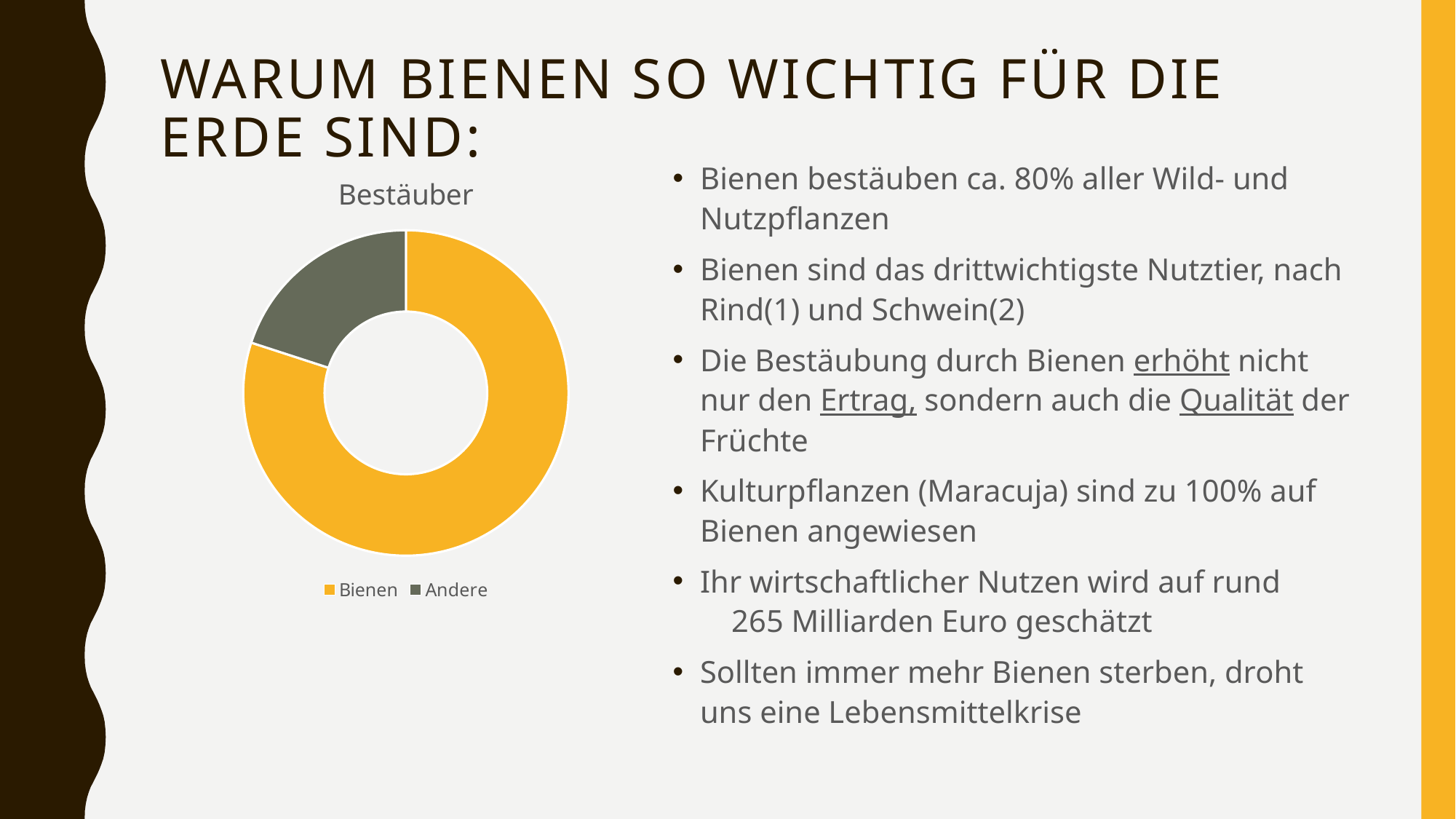
What colour represents Bienen in the chart? yellow How many entries does the chart legend list? 2 Which category has the largest share of the chart? Bienen What type of chart is shown on the slide? doughnut chart What is the title of the chart? Bestäuber How many categories does the chart show? 2 Which is larger in the chart, Bienen or Andere? Bienen Which category is shown in grey in the chart? Andere Which category has the smallest share of the chart? Andere